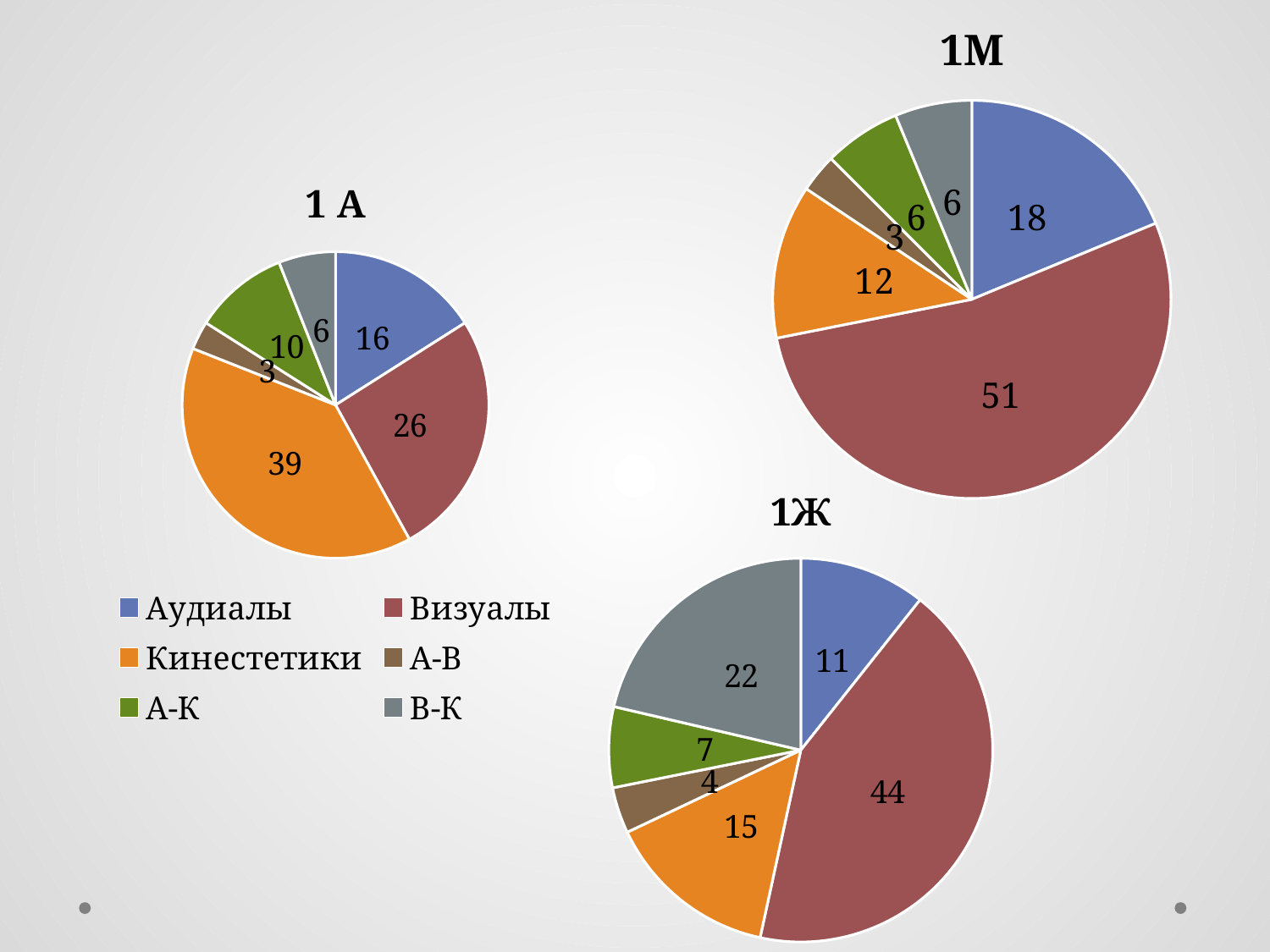
How many slices does the "1М" pie chart have? 6 In the "1Ж" pie chart, what is the value for В-К? 22 In the "1Ж" pie chart, which category has the largest slice? Визуалы How many categories does the legend list? 6 In the "1 А" pie chart, which category has the smallest slice? А-В In the "1М" pie chart, what is the difference between the values for Визуалы and Аудиалы? 33 In the "1М" pie chart, what is the value for Визуалы? 51 In the "1Ж" pie chart, which is larger: Кинестетики or Аудиалы? Кинестетики Which colour represents Визуалы in the legend? Red In the "1 А" pie chart, what is the value for Кинестетики? 39 What type of chart is used for "1 А"? Pie chart In the "1 А" pie chart, what share of the total does Кинестетики represent? 39%